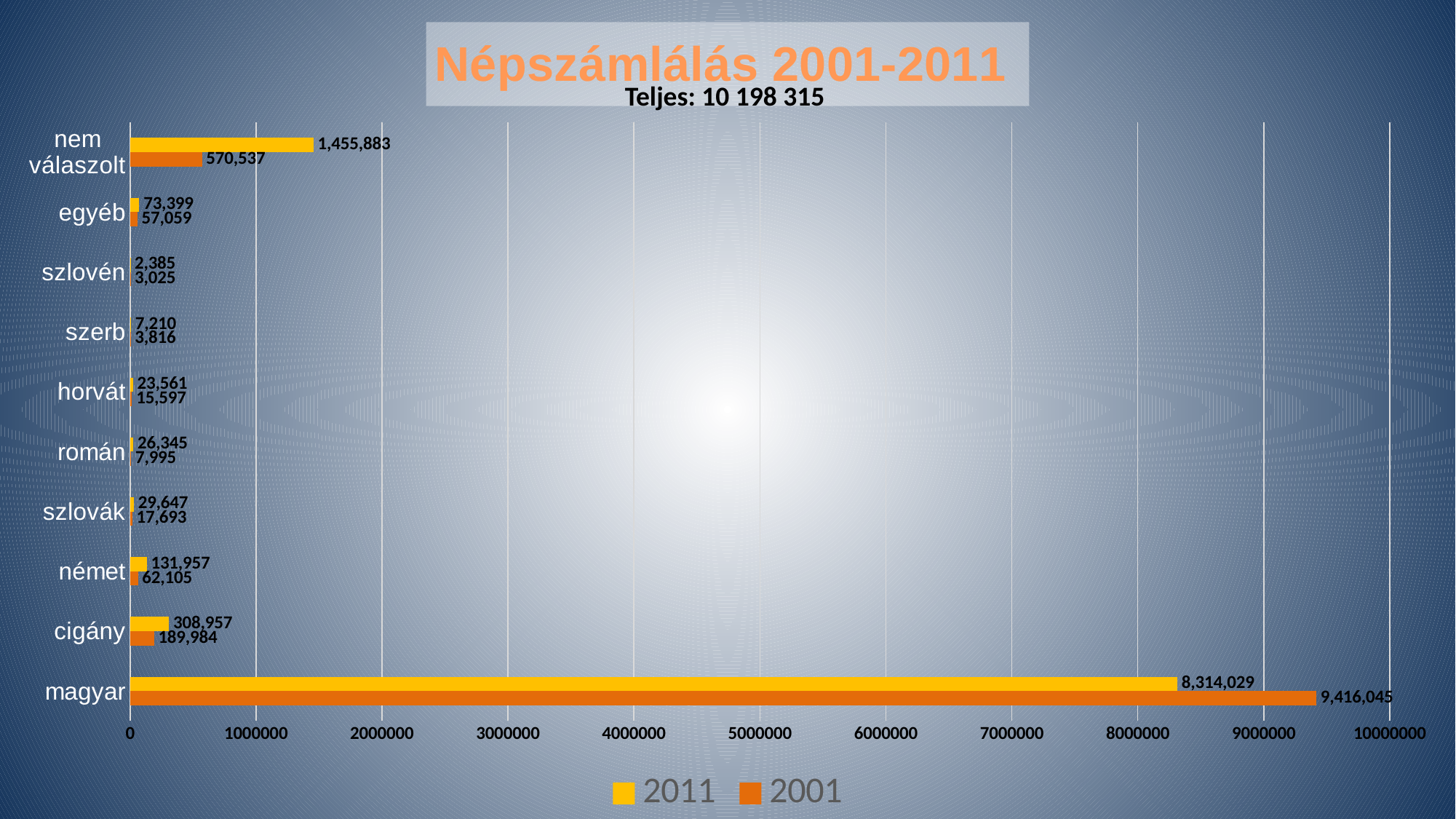
What is the difference between the 2001 and 2011 values for magyar? 1,102,016 Which is larger for szlovén, the 2011 value or the 2001 value? 2001 What is the difference between the 2011 and 2001 values for nem válaszolt? 885,346 Which category has the highest 2001 value? magyar What is the 2011 value for magyar? 8,314,029 How many series does the legend list? 2 What is the 2011 value for cigány? 308,957 What kind of chart is shown on the slide? bar chart What is the 2001 value for nem válaszolt? 570,537 How many categories are shown on the chart? 10 Which category has the lowest 2011 value? szlovén What is the 2001 value for német? 62,105